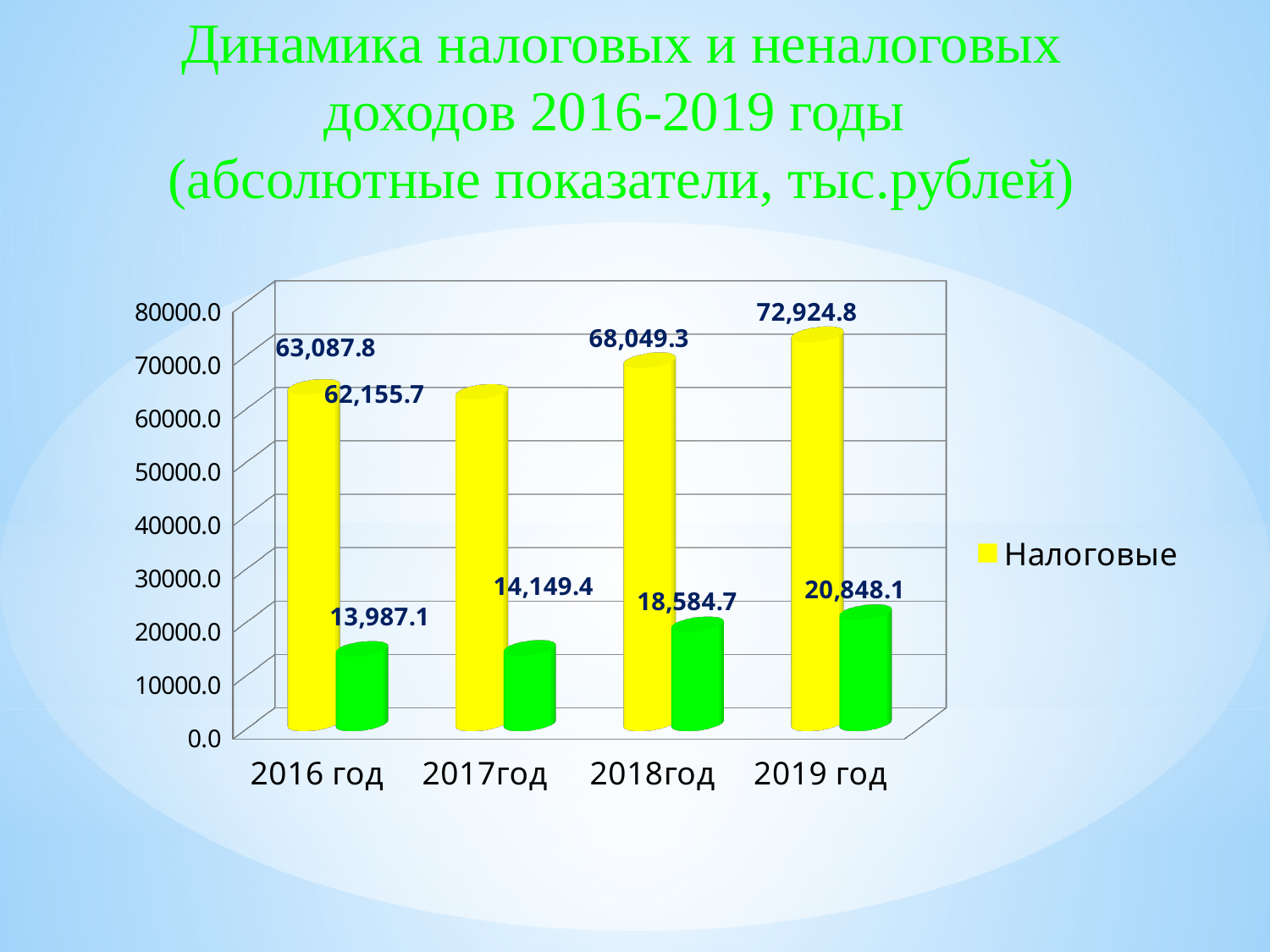
Which is larger: the green bar for 2017год or the green bar for 2018год? 2018год What kind of chart is shown on the slide? bar chart In which year is the Налоговые (yellow) bar the lowest? 2017год What is the value of the green bar for 2018год? 18,584.7 What is the difference between the Налоговые values for 2019 год and 2018год? 4,875.5 What is the value of the Налоговые (yellow) bar for 2019 год? 72,924.8 In which year is the Налоговые (yellow) bar the highest? 2019 год What is the value of the Налоговые (yellow) bar for 2017год? 62,155.7 How many years are shown on the x axis of the chart? 4 Is the Налоговые value for 2018год greater or less than 70000.0? less Do the green bar values rise or fall from 2016 год to 2019 год? rise What is the value of the green bar for 2016 год? 13,987.1